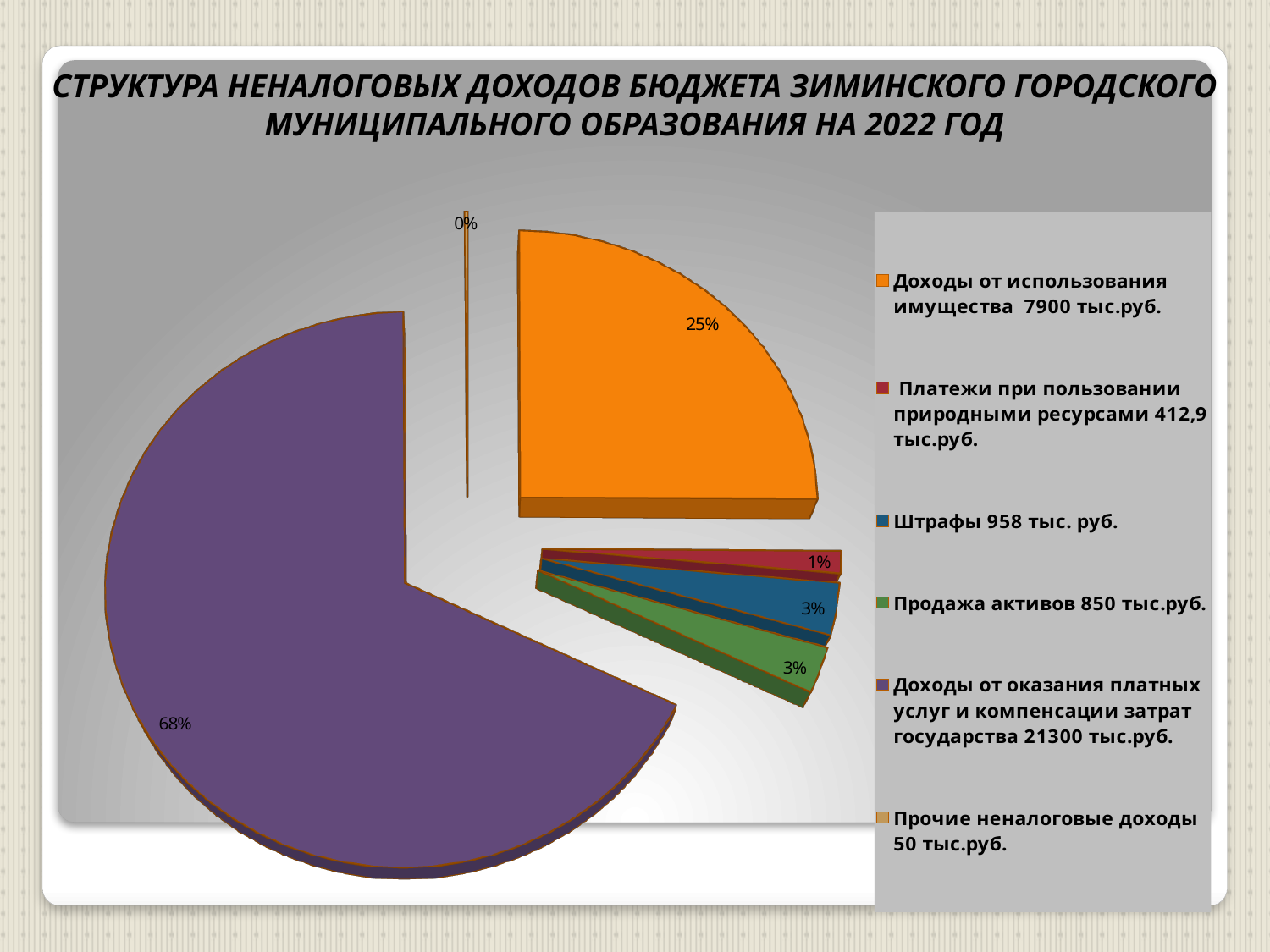
How many slices does the pie chart have? 6 What share of the pie is labelled for "Доходы от оказания платных услуг и компенсации затрат государства"? 68% How many entries does the legend list? 6 What share of the pie is labelled for "Прочие неналоговые доходы"? 0% What kind of chart is shown on the slide? pie chart What share of the pie is labelled for "Доходы от использования имущества"? 25% Which slice is larger: "Доходы от использования имущества" or "Штрафы"? Доходы от использования имущества What amount in тыс.руб. does the legend give for "Штрафы"? 958 тыс. руб. What is the difference in percentage points between the 68% slice and the 25% slice? 43% Which category has the largest slice of the pie? Доходы от оказания платных услуг и компенсации затрат государства Which category has the smallest slice of the pie? Прочие неналоговые доходы